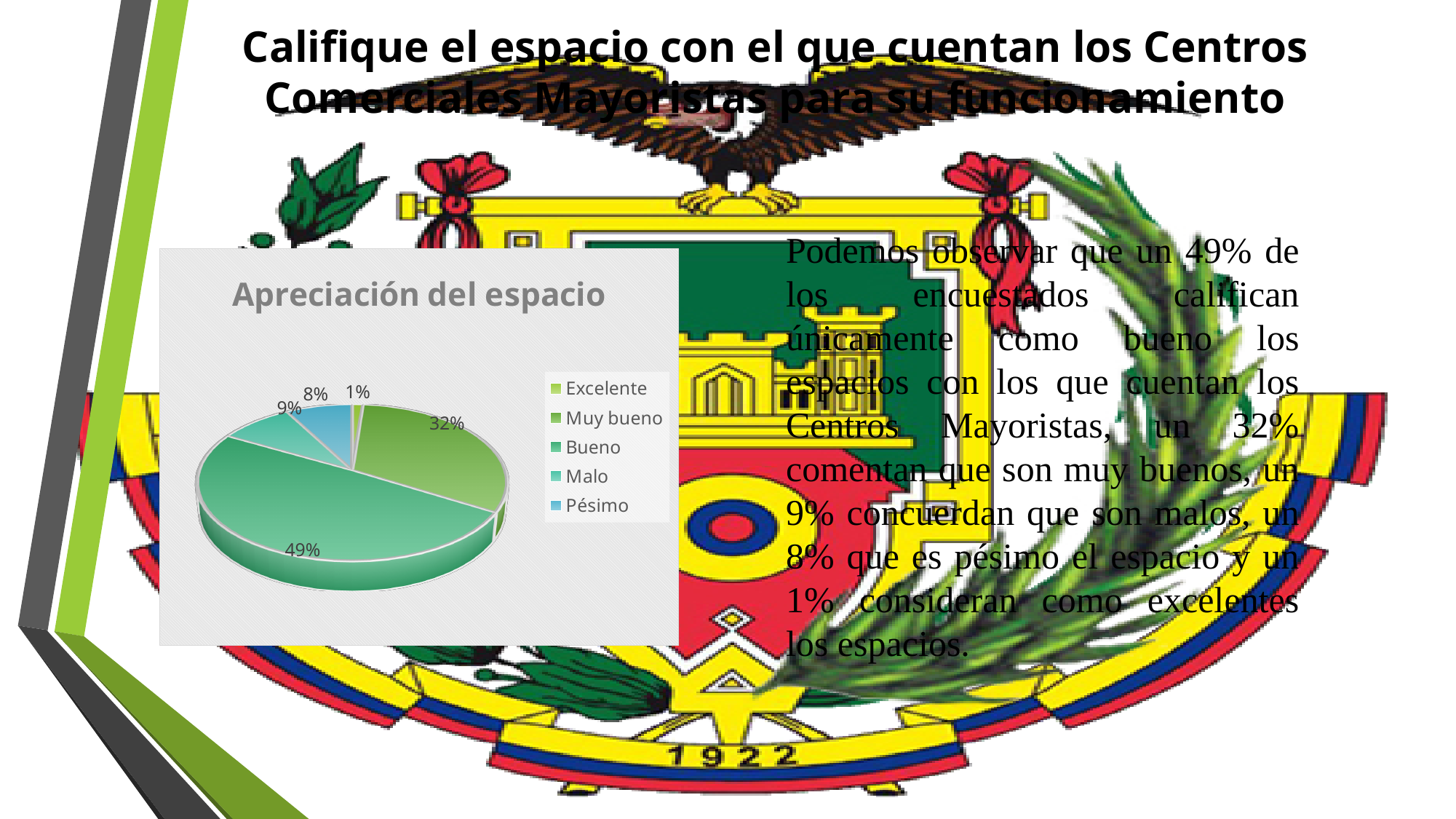
Which category has the largest share of the pie? Bueno How many categories does the legend of the chart list? 5 What type of chart is shown on the slide? Pie chart What is the title of the chart? Apreciación del espacio What is the difference in percentage points between 'Bueno' and 'Muy bueno'? 17 What share of the pie does 'Bueno' represent? 49% What share of the pie does 'Excelente' represent? 1% What share of the pie does 'Malo' represent? 9% Which is larger, the share for 'Malo' or the share for 'Pésimo'? Malo Which category has the smallest share of the pie? Excelente